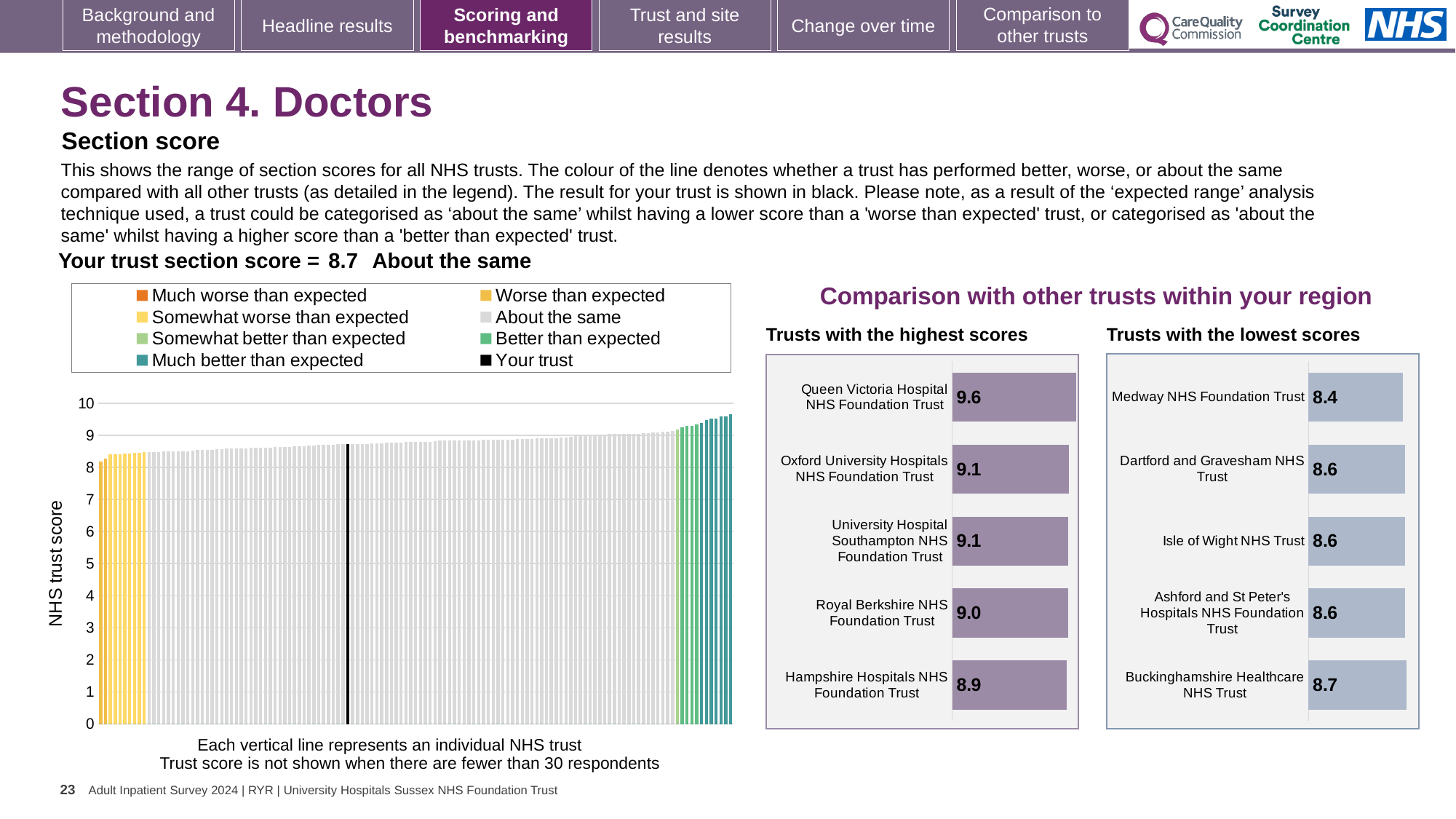
In the main chart on the left showing all NHS trusts, do the trust scores rise or fall from left to right? rise In the 'Trusts with the lowest scores' chart, what is the score for Medway NHS Foundation Trust? 8.4 In the 'Trusts with the lowest scores' chart, what is the difference between the scores of Buckinghamshire Healthcare NHS Trust and Medway NHS Foundation Trust? 0.3 In the 'Trusts with the lowest scores' chart, which is larger: the score for Medway NHS Foundation Trust or the score for Isle of Wight NHS Trust? Isle of Wight NHS Trust In the 'Trusts with the highest scores' chart, what is the difference between the scores of Queen Victoria Hospital NHS Foundation Trust and Hampshire Hospitals NHS Foundation Trust? 0.7 In the 'Trusts with the highest scores' chart, what is the score for Queen Victoria Hospital NHS Foundation Trust? 9.6 In the 'Trusts with the highest scores' chart, how many trusts are listed? 5 In the 'Trusts with the lowest scores' chart, which trust has the highest score shown? Buckinghamshire Healthcare NHS Trust How many entries does the legend of the main chart on the left list? 8 In the main chart on the left showing all NHS trusts, what is the section score for your trust? 8.7 In the 'Trusts with the highest scores' chart, which trust has the lowest score shown? Hampshire Hospitals NHS Foundation Trust What kind of chart is the 'Trusts with the highest scores' chart? bar chart